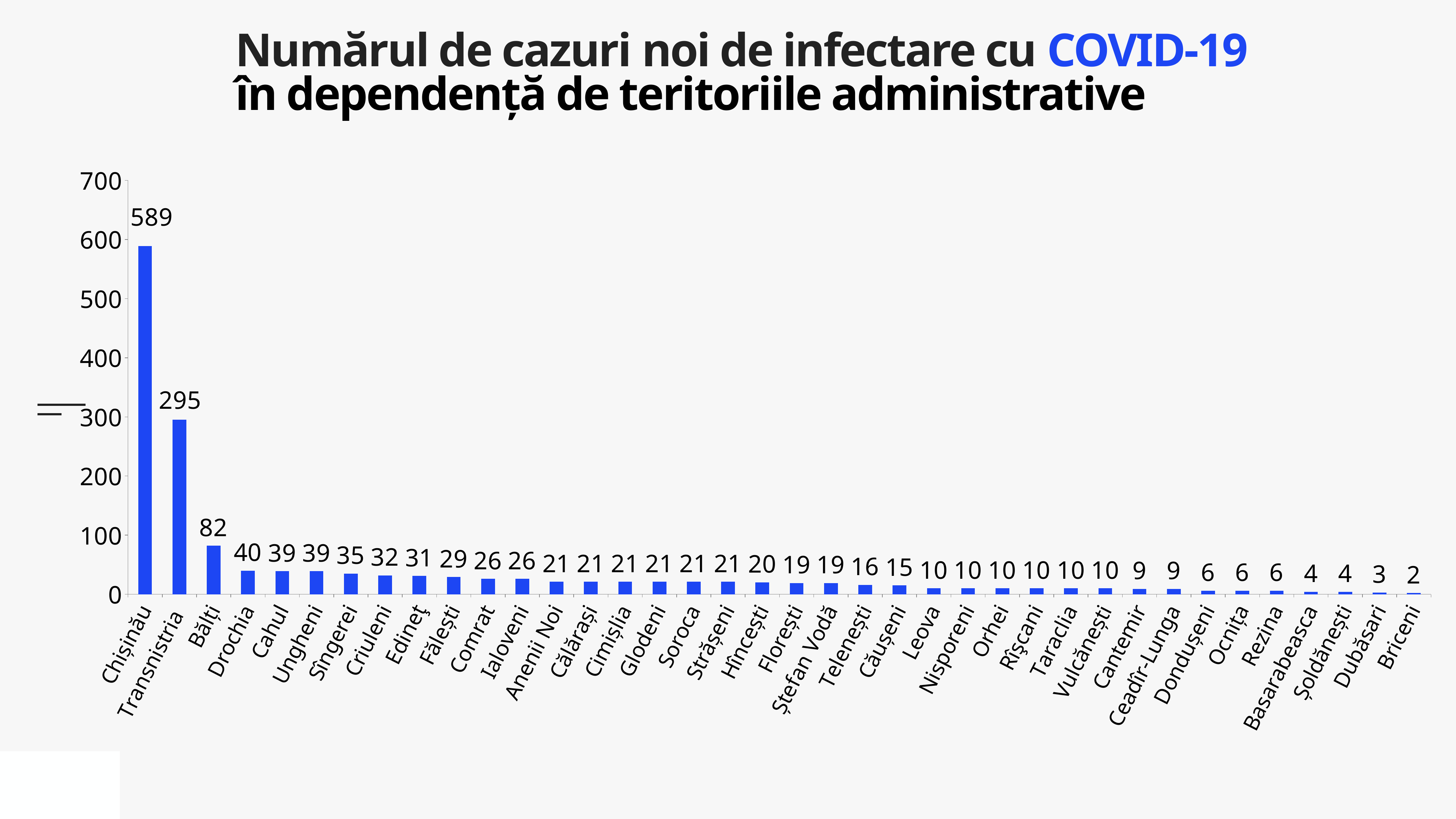
What is the difference between the values for Chișinău and Transnistria? 294 Which category has the highest value? Chișinău Which is larger, the value for Drochia or the value for Cahul? Drochia Which category has the lowest value? Briceni What is the value for Soroca? 21 Is the value for Bălți greater or less than 100? less What is the value for Transnistria? 295 What is the value for Bălți? 82 What kind of chart is shown on the slide? bar chart What is the value for Chișinău? 589 Do the values rise or fall from left to right along the x axis? fall How many categories are shown on the x axis? 38